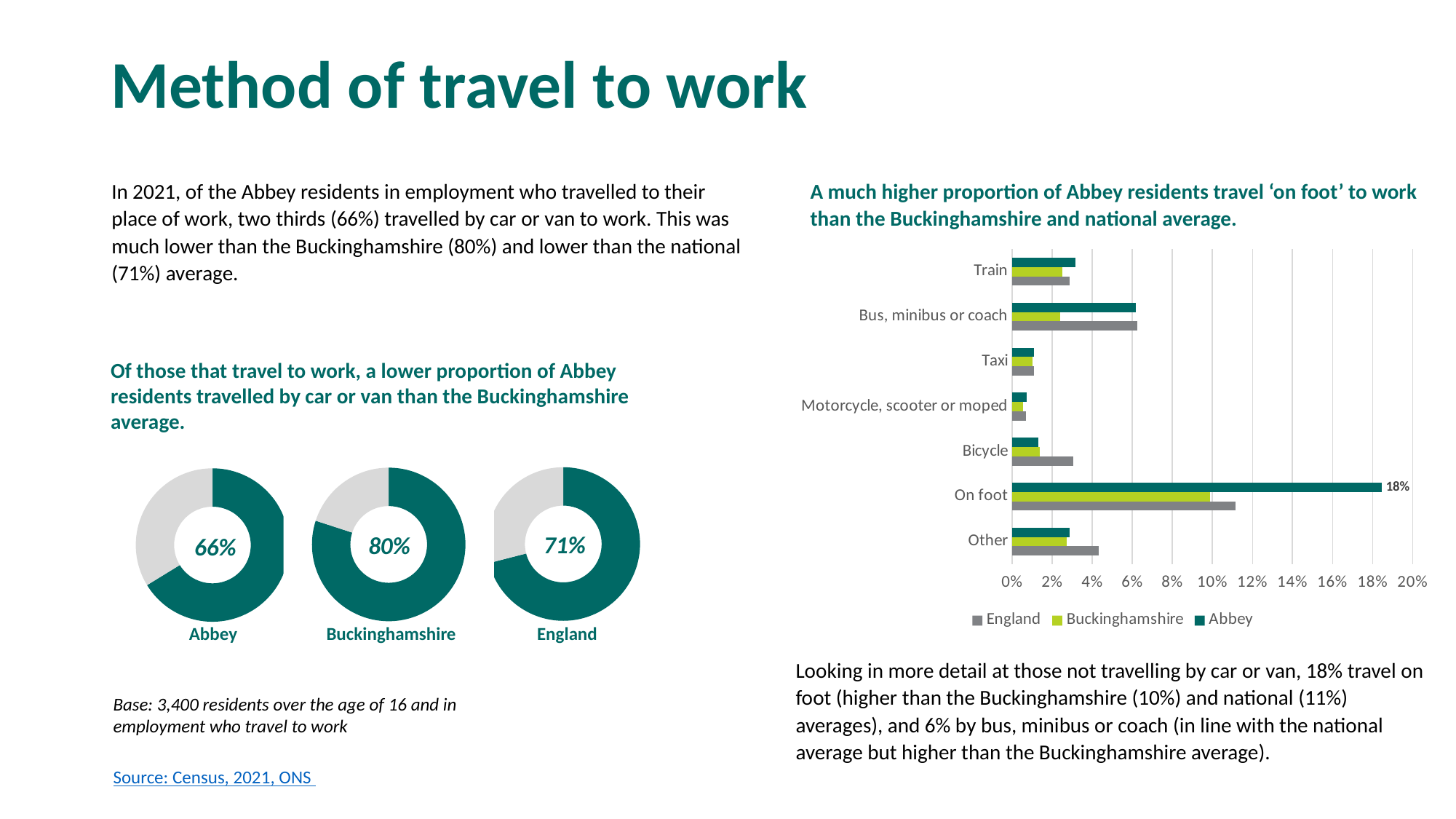
How many series does the legend of the bar chart on the right list? 3 Among the three donut charts, which area has the lowest proportion travelling by car or van? Abbey In the donut charts, what percentage of Abbey residents travelled to work by car or van? 66% In the bar chart on the right, is the value for Abbey for 'Bus, minibus or coach' greater or less than 4%? greater In the bar chart on the right, what is the value for Abbey for 'On foot'? 18% In the bar chart on the right, which category has the highest value for Abbey? On foot How many travel method categories are shown in the bar chart on the right? 7 In the donut charts, what is the difference in percentage points between Buckinghamshire and Abbey? 14 percentage points In the donut charts, what percentage is shown for Buckinghamshire? 80% In the donut charts, what percentage is shown for England? 71% What kind of chart is the chart on the right showing methods of travel such as Train and On foot? Bar chart Among the three donut charts, which area has the highest proportion travelling by car or van? Buckinghamshire